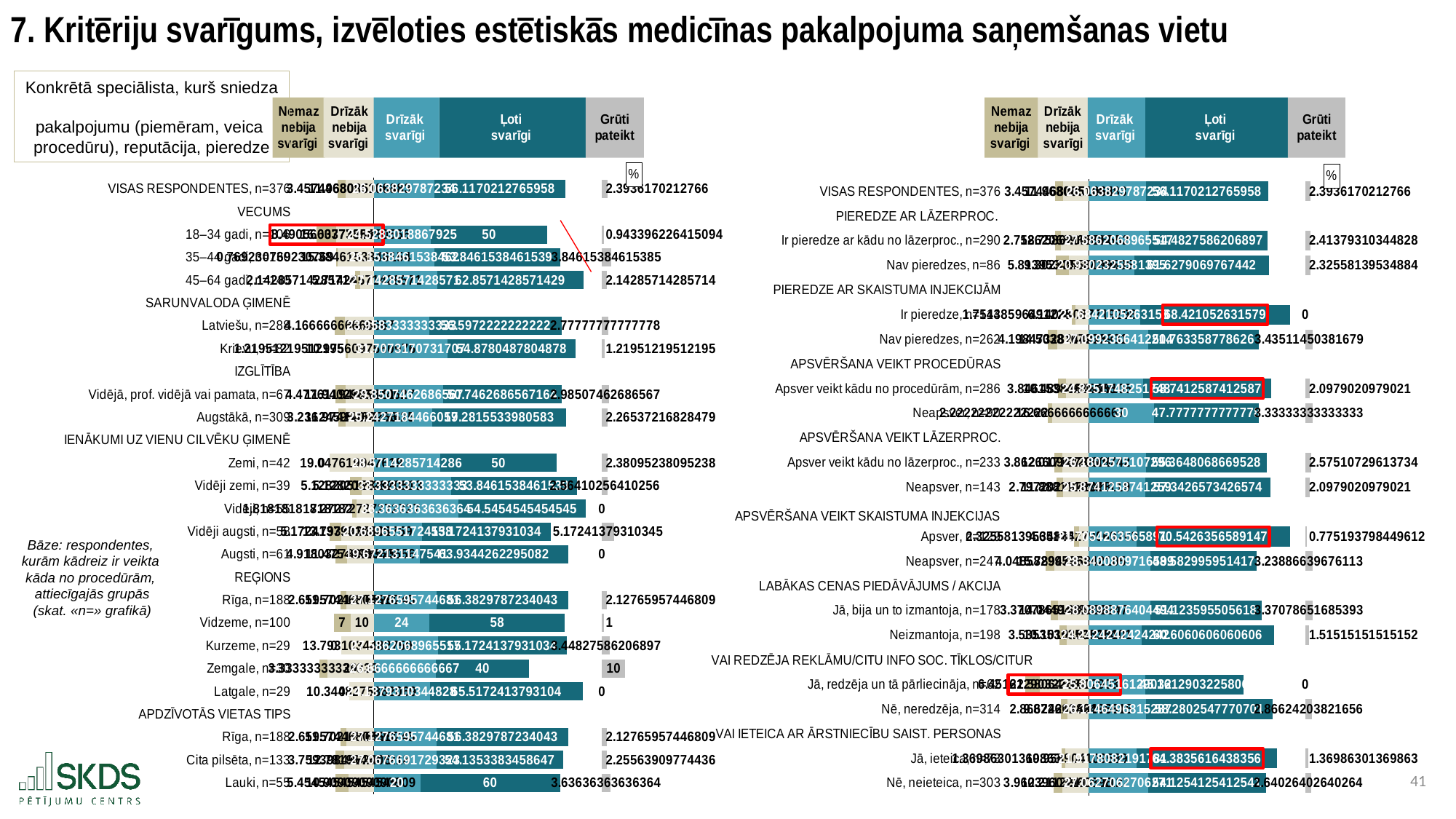
What kind of chart is used on the left side of the slide? bar chart In the left chart, which has the larger 'Ļoti svarīgi' value: Vidzeme, n=100 or Zemgale, n=30? Vidzeme, n=100 In the right chart, what is the 'Ļoti svarīgi' value for 'Ir pieredze' under 'Pieredze ar skaistuma injekcijām'? 68.421052631579 In the right chart, what is the 'Grūti pateikt' value for 'Ir pieredze' under 'Pieredze ar skaistuma injekcijām'? 0 In the left chart, what is the difference between the 'Ļoti svarīgi' and 'Drīzāk svarīgi' values for Vidzeme, n=100? 34 How many series does the legend of the left chart list? 5 In the left chart, what is the 'Ļoti svarīgi' value for Lauki, n=55? 60 In the left chart, what is the 'Grūti pateikt' value for Vidzeme, n=100? 1 In the left chart, what is the 'Drīzāk svarīgi' value for Vidzeme, n=100? 24 In the left chart, what is the 'Ļoti svarīgi' value for Vidzeme, n=100? 58 In the left chart, what is the 'Ļoti svarīgi' value for Zemgale, n=30? 40 In the left chart, what is the 'Grūti pateikt' value for Zemgale, n=30? 10